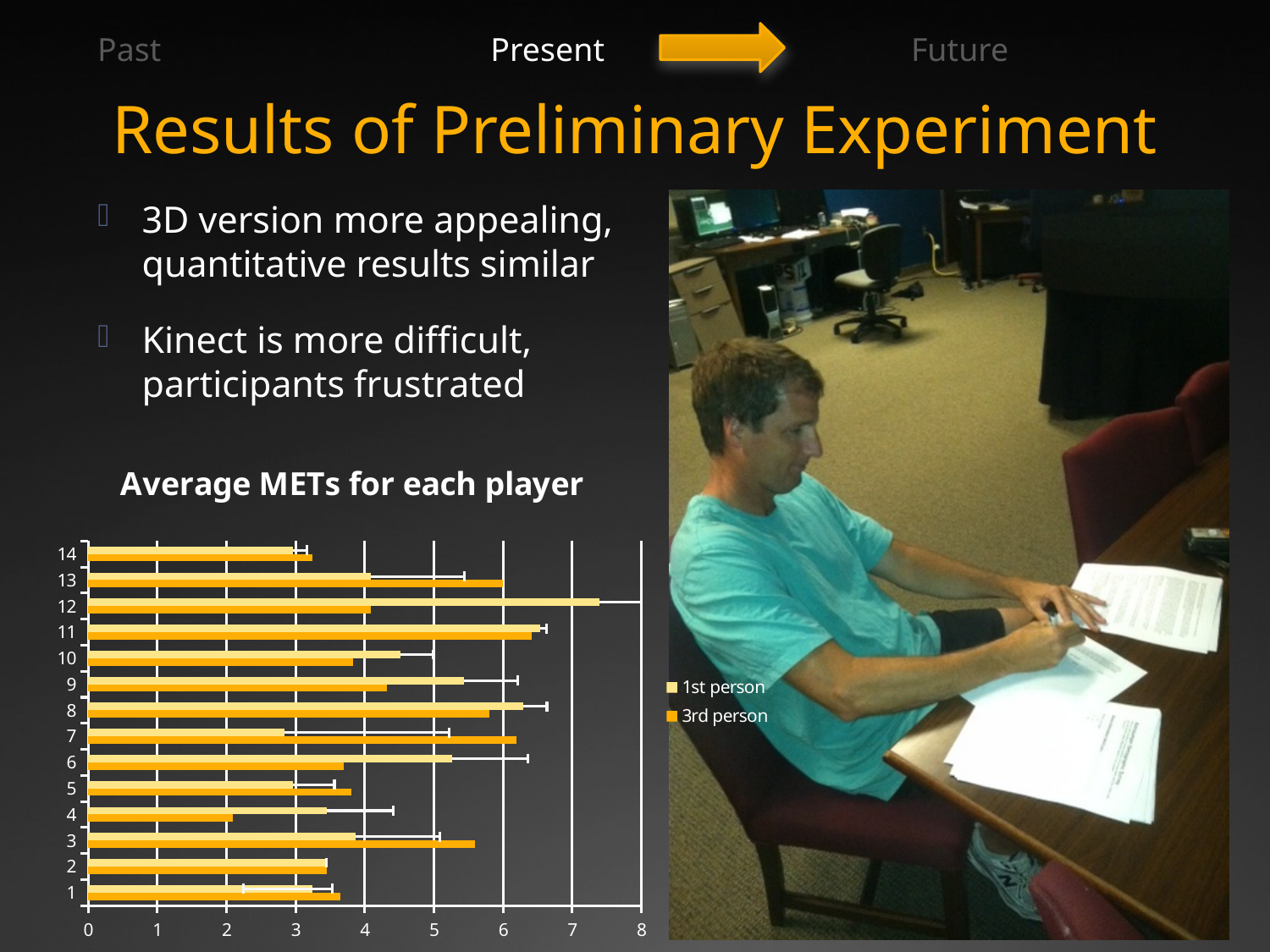
For player 12, which is larger: the 1st person value or the 3rd person value? 1st person How many series does the chart's legend list? 2 For player 7, which is larger: the 1st person value or the 3rd person value? 3rd person Is the 1st person value for player 12 greater or less than 7? greater What kind of chart is shown on the slide? bar chart Which player has the lowest 3rd person value? 4 How many players (categories) are plotted on the chart? 14 Is the 3rd person value for player 13 greater or less than 5? greater Which player has the highest 1st person value? 12 What are the two series named in the chart's legend? 1st person and 3rd person Is the 3rd person value for player 4 greater or less than 3? less What is the title of the chart on the slide? Average METs for each player